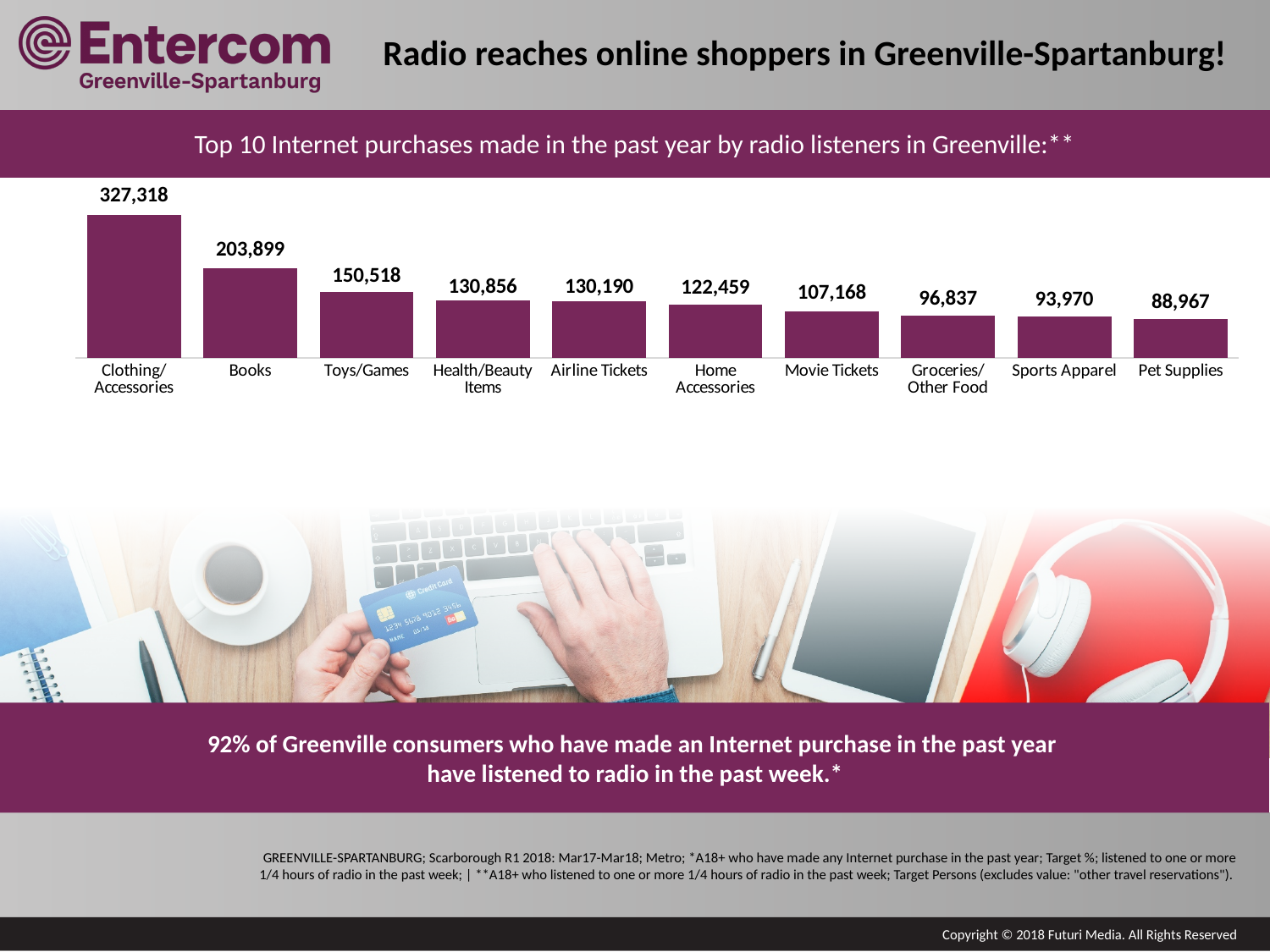
What kind of chart is shown on the slide? Bar chart What is the value for Pet Supplies? 88,967 Which category has the lowest value? Pet Supplies Which is larger, the value for Toys/Games or the value for Home Accessories? Toys/Games Do the values rise or fall from left to right across the categories? Fall What is the value for Airline Tickets? 130,190 How many categories are shown in the chart? 10 What is the difference between the values for Clothing/Accessories and Books? 123,419 What is the title of the chart? Top 10 Internet purchases made in the past year by radio listeners in Greenville:** What is the difference between the values for Movie Tickets and Groceries/Other Food? 10,331 Which category has the highest value? Clothing/Accessories What is the value for Books? 203,899